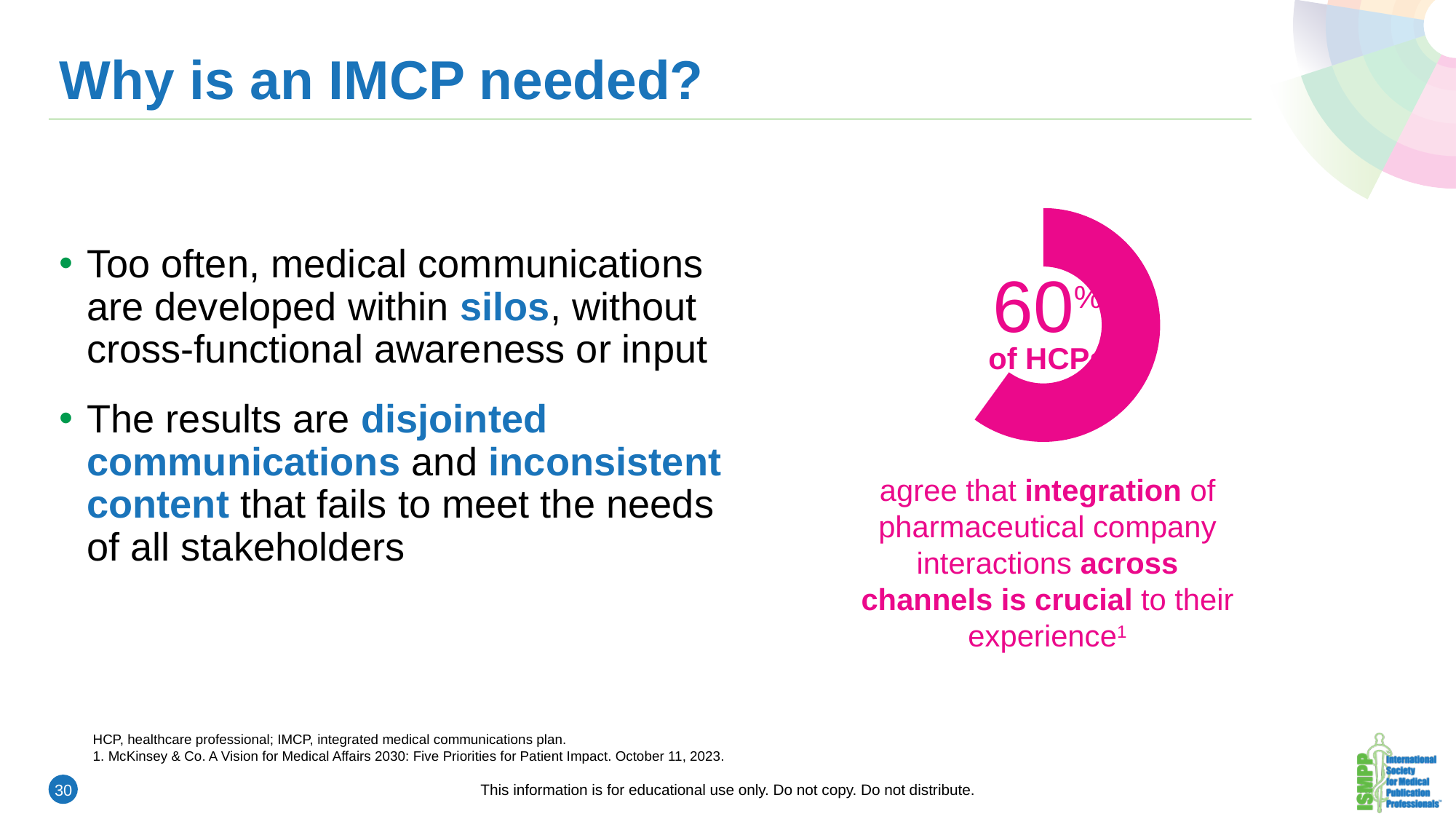
What percentage of HCPs does the donut chart show agree that integration of pharmaceutical company interactions across channels is crucial to their experience? 60% What colour is the filled portion of the donut chart? Pink Which group of people does the 60% figure in the donut chart refer to? HCPs Does the donut chart show that more or less than half of HCPs agree that cross-channel integration is crucial? More than half What kind of chart is shown on the right side of the slide? Donut chart What share of the donut chart is filled in to represent HCPs who agree? 60% Is the value shown in the donut chart greater or less than 50%? greater